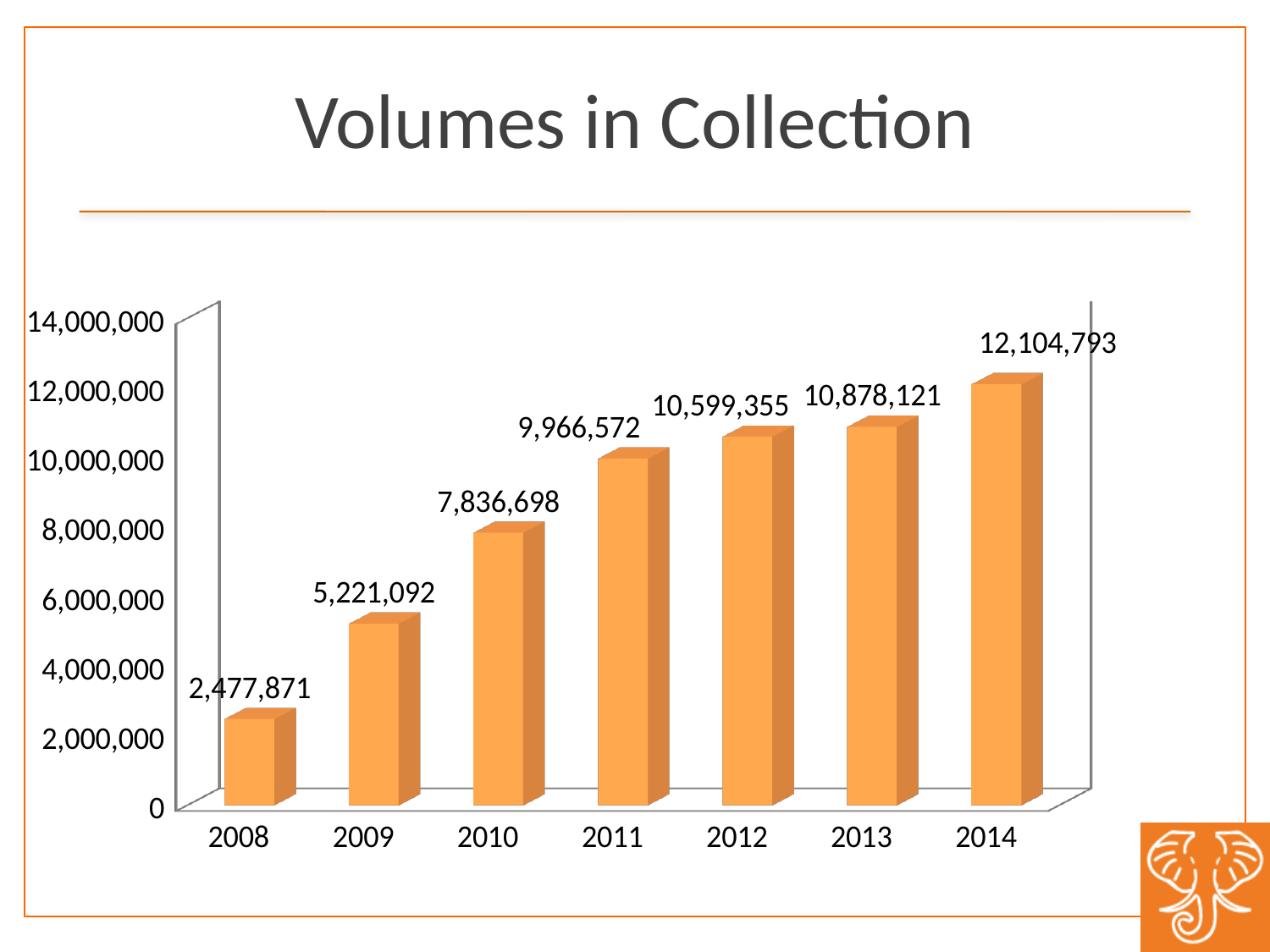
What is the value for 2014? 12,104,793 What is the value for 2011? 9,966,572 How many years are shown on the x axis? 7 Which year has the lowest volume in collection? 2008 Do the values rise or fall from 2008 to 2014? rise What kind of chart is shown on the slide? bar chart What is the value for 2008? 2,477,871 Which is larger, the value for 2010 or the value for 2012? 2012 Which year has the highest volume in collection? 2014 What is the difference between the values for 2009 and 2008? 2,743,221 Is the value for 2013 greater or less than 10,000,000? greater What is the difference between the values for 2014 and 2008? 9,626,922